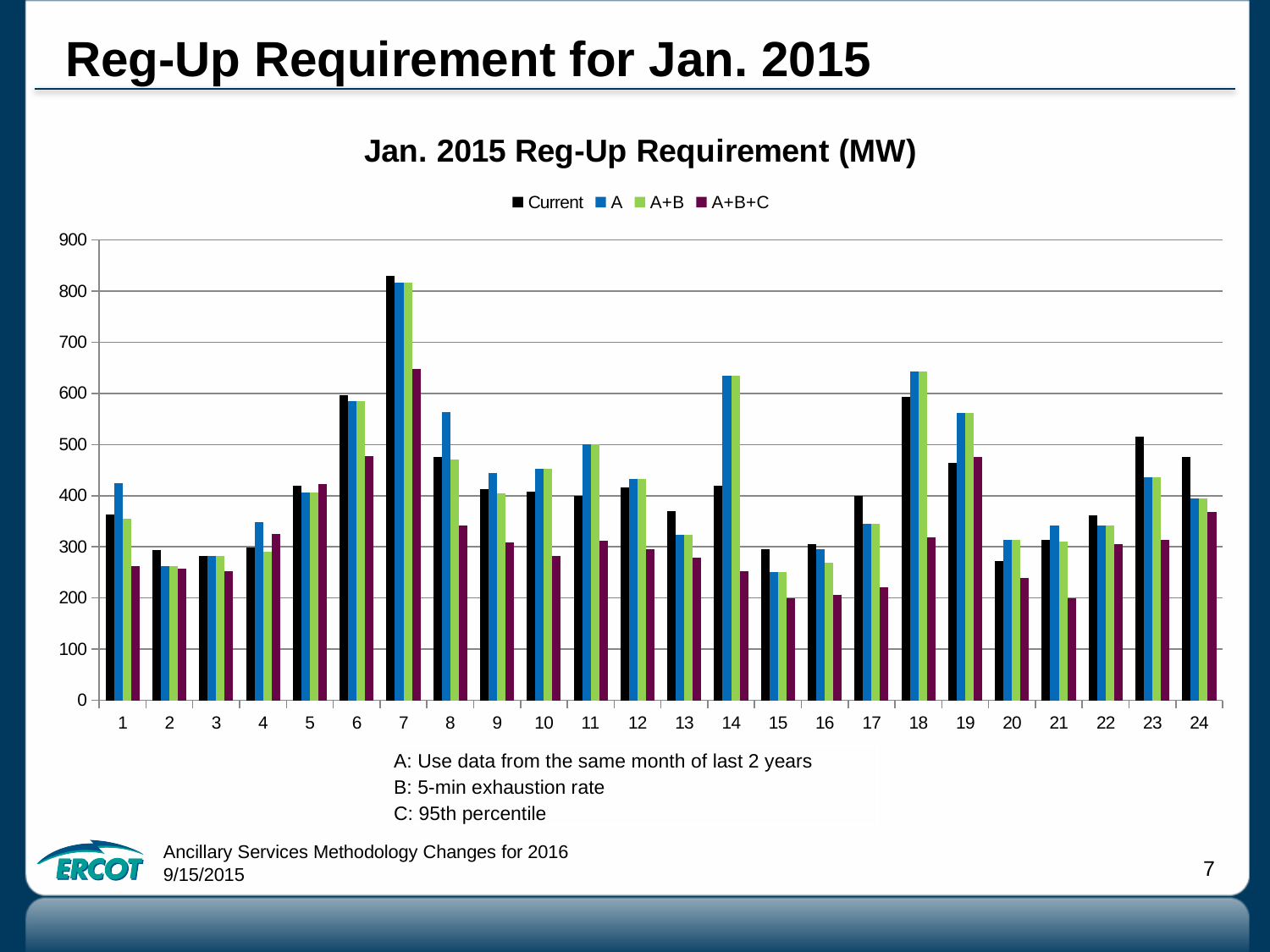
What kind of chart is shown on the slide? bar chart Is the Current value for hour 20 greater or less than 300? less What is the title of the chart? Jan. 2015 Reg-Up Requirement (MW) Is the Current value for hour 7 greater or less than 800? greater How many series does the legend list? 4 Is the A value for hour 14 greater or less than 600? greater For hour 23, which is larger: the Current value or the A value? Current For which hour is the Current value highest? 7 For hour 14, which is larger: the Current value or the A value? A Which series is shown in black in the legend? Current How many hour categories are shown on the x axis? 24